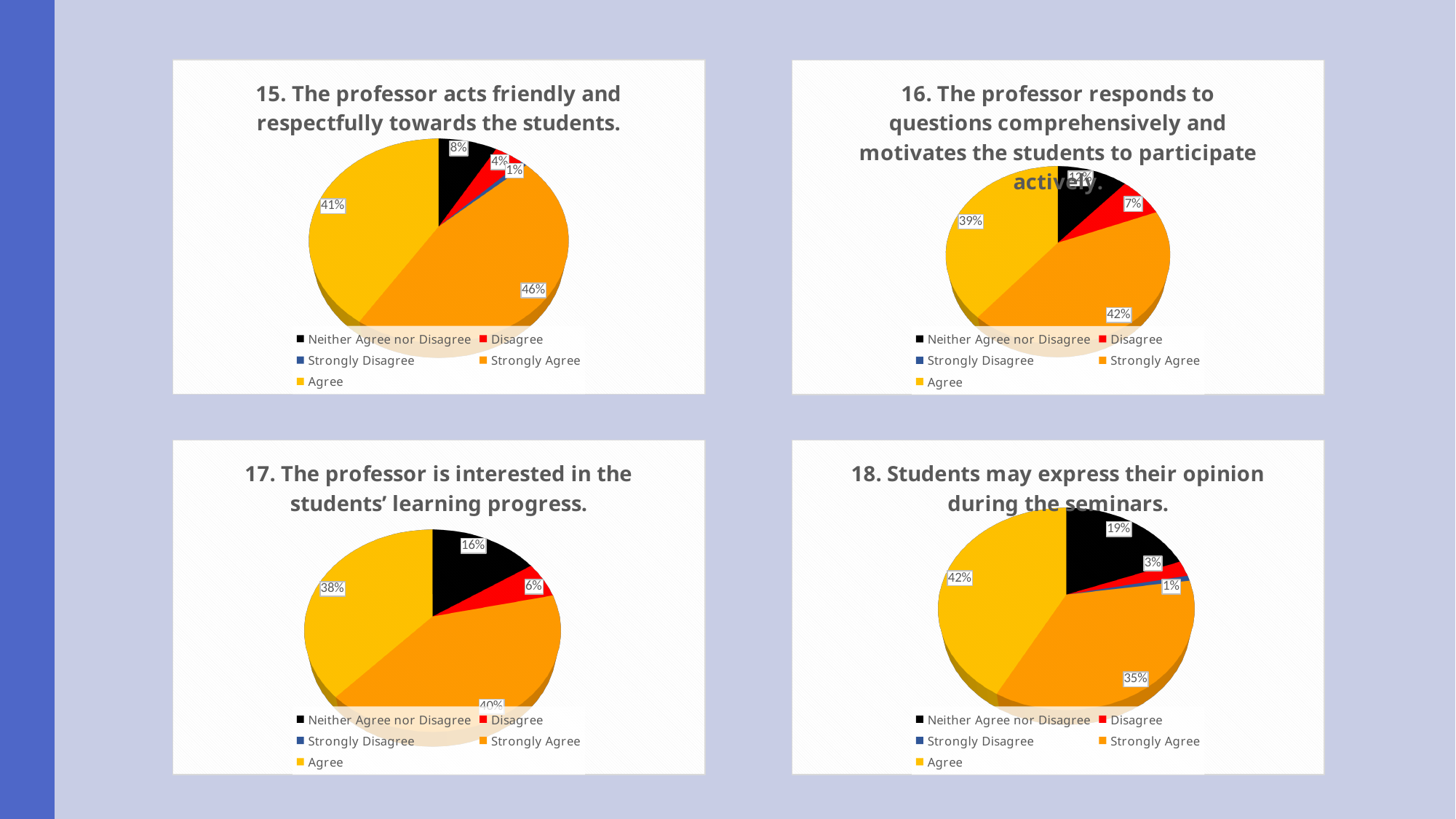
In the chart titled "18. Students may express their opinion during the seminars.", what percentage is shown for Agree? 42% In the chart titled "16. The professor responds to questions comprehensively and motivates the students to participate actively.", what percentage is shown for Disagree? 7% How many categories does the legend list in the chart titled "15. The professor acts friendly and respectfully towards the students."? 5 In the chart titled "18. Students may express their opinion during the seminars.", what is the difference between Neither Agree nor Disagree and Disagree? 16% In the chart titled "16. The professor responds to questions comprehensively and motivates the students to participate actively.", which category has the largest slice? Strongly Agree In the chart titled "15. The professor acts friendly and respectfully towards the students.", which category has the smallest slice? Strongly Disagree In the chart titled "17. The professor is interested in the students' learning progress.", what is the difference between the Agree and Disagree percentages? 32% In the chart titled "17. The professor is interested in the students' learning progress.", what percentage is shown for Neither Agree nor Disagree? 16% What type of chart is used in the top-left chart on the slide? Pie chart In the chart titled "18. Students may express their opinion during the seminars.", which is larger, Agree or Strongly Agree? Agree In the chart titled "15. The professor acts friendly and respectfully towards the students.", what percentage is shown for Strongly Agree? 46% In the chart titled "15. The professor acts friendly and respectfully towards the students.", what percentage is shown for Agree? 41%